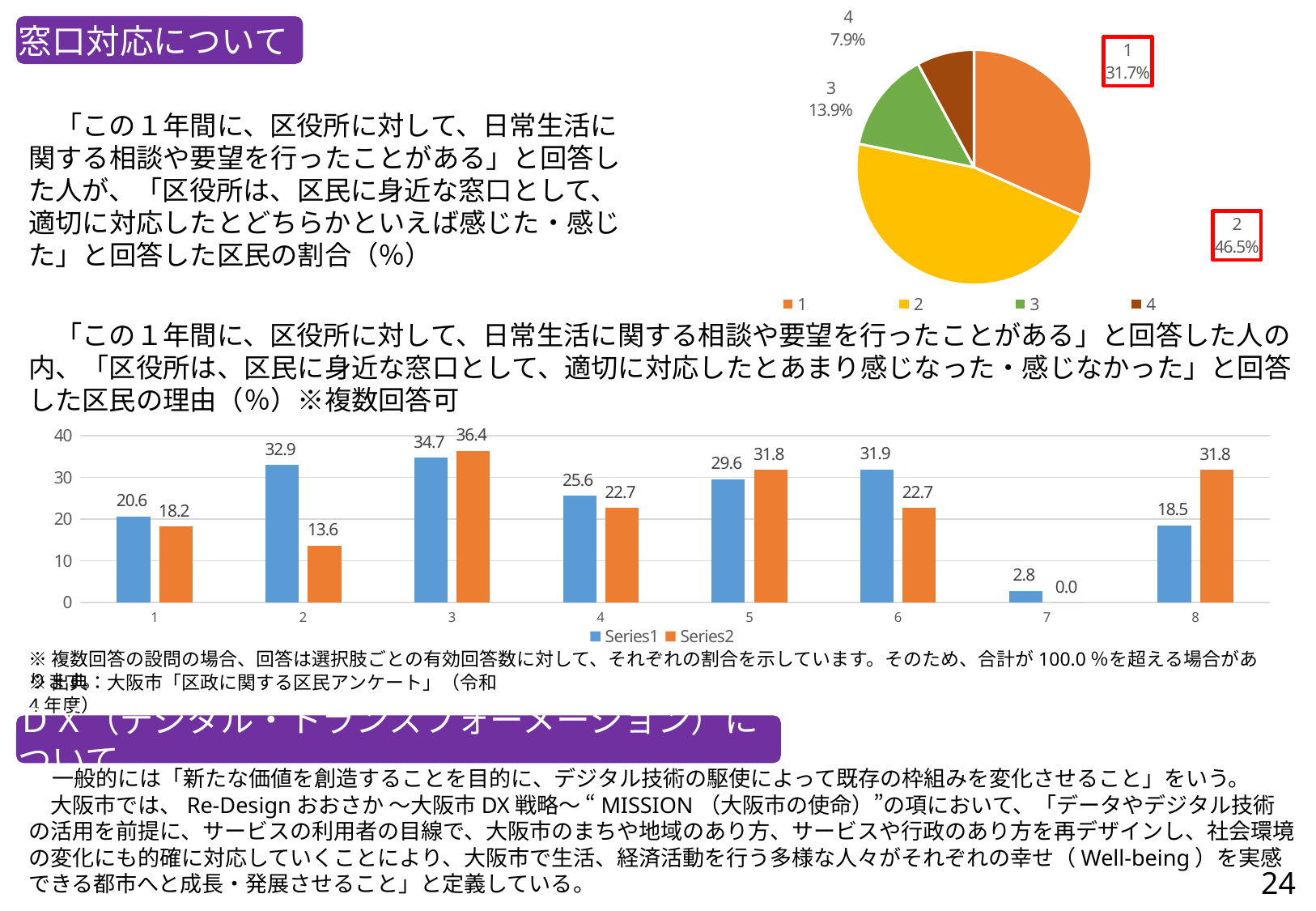
In the pie chart at the top right, what is the share for category 2? 46.5% In the bar chart at the bottom, what is the Series2 value for category 7? 0.0 What type of chart is shown at the bottom of the slide? Bar chart In the bar chart at the bottom, what is the Series1 value for category 3? 34.7 In the pie chart at the top right, which category has the largest slice? 2 In the pie chart at the top right, which category has the smallest slice? 4 In the bar chart at the bottom, which category has the highest Series2 value? 3 In the bar chart at the bottom, for category 8, which series has the larger value? Series2 In the bar chart at the bottom, how many series does the legend list? 2 In the bar chart at the bottom, what is the difference between the Series1 and Series2 values for category 2? 19.3 In the bar chart at the bottom, which category has the lowest Series1 value? 7 In the pie chart at the top right, how many categories does the legend list? 4